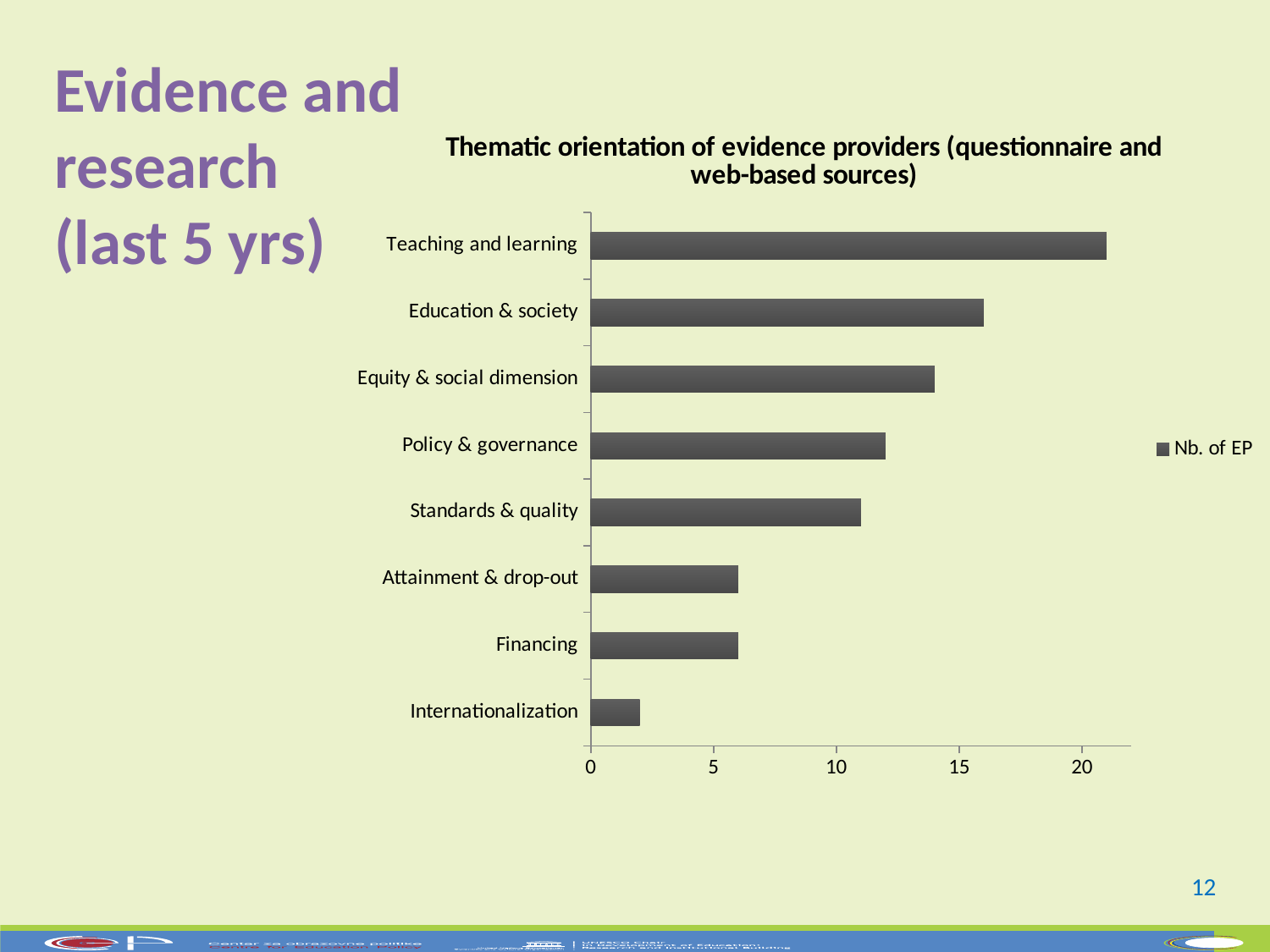
Is the value for Internationalization greater or less than 5? less Which is larger, the value for Equity & social dimension or the value for Policy & governance? Equity & social dimension Is the value for Standards & quality greater or less than 10? greater Which category has the highest value? Teaching and learning Which category has the lowest value? Internationalization Which is larger, the value for Financing or the value for Standards & quality? Standards & quality How many series does the legend list? 1 Is the value for Teaching and learning greater or less than 20? greater What kind of chart is shown on the slide? bar chart What is the name of the series shown in the legend? Nb. of EP How many categories are shown on the chart? 8